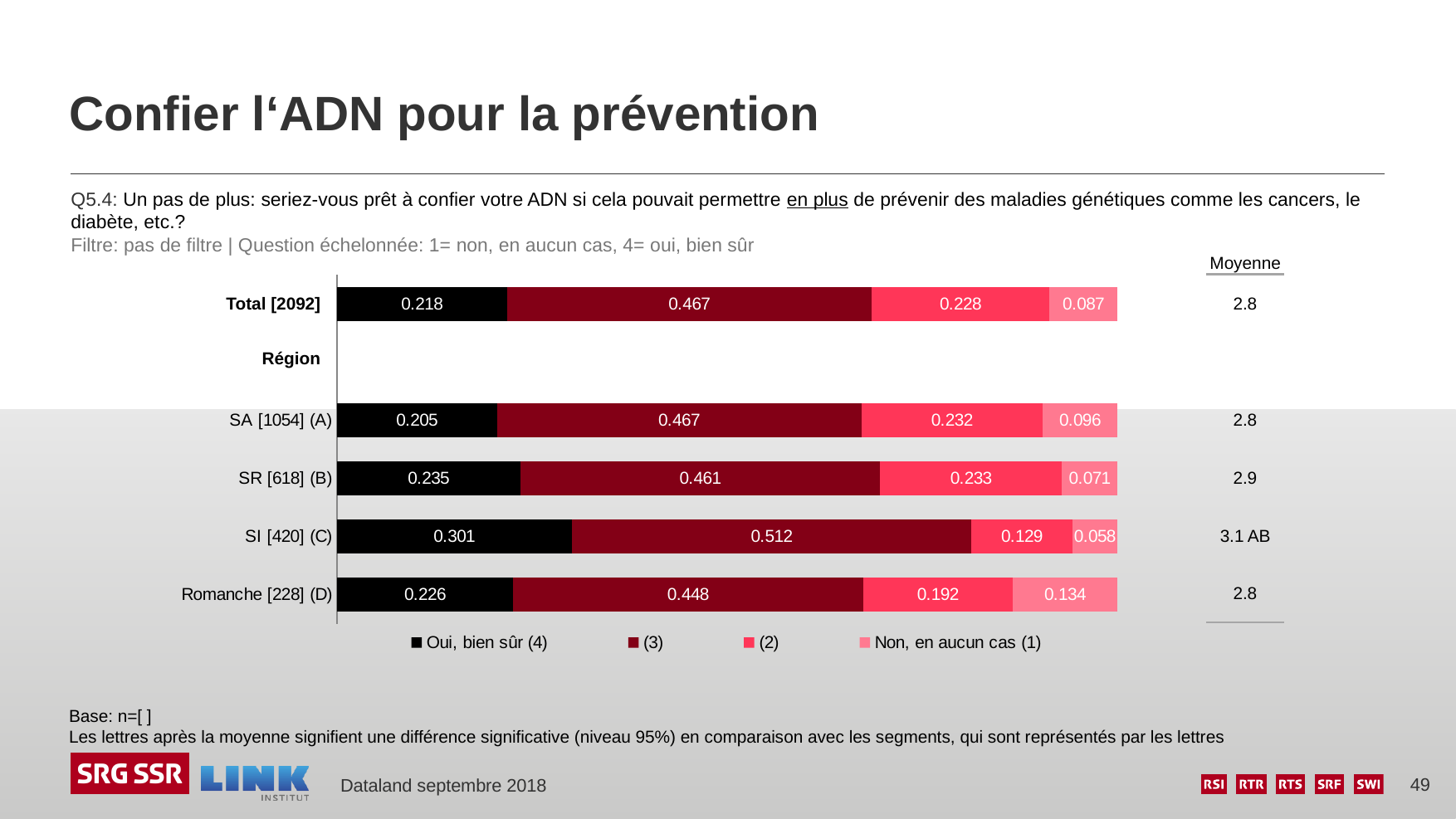
What is the value of the 'Oui, bien sûr (4)' segment for SI [420] (C)? 0.301 Which category has the lowest 'Non, en aucun cas (1)' value? SI [420] (C) What Moyenne is shown for SI [420] (C)? 3.1 AB What is the value of the 'Non, en aucun cas (1)' segment for Romanche [228] (D)? 0.134 Which has the larger '(2)' value, SR [618] (B) or Romanche [228] (D)? SR [618] (B) How many bars are plotted in the chart? 5 How many series does the legend list? 4 What is the value of the '(3)' segment for Total [2092]? 0.467 What is the difference between the 'Oui, bien sûr (4)' values for SI [420] (C) and SA [1054] (A)? 0.096 What kind of chart is shown on the slide? Stacked bar chart What is the total of the stacked bar for SI [420] (C)? 1.000 Which category has the highest 'Oui, bien sûr (4)' value? SI [420] (C)